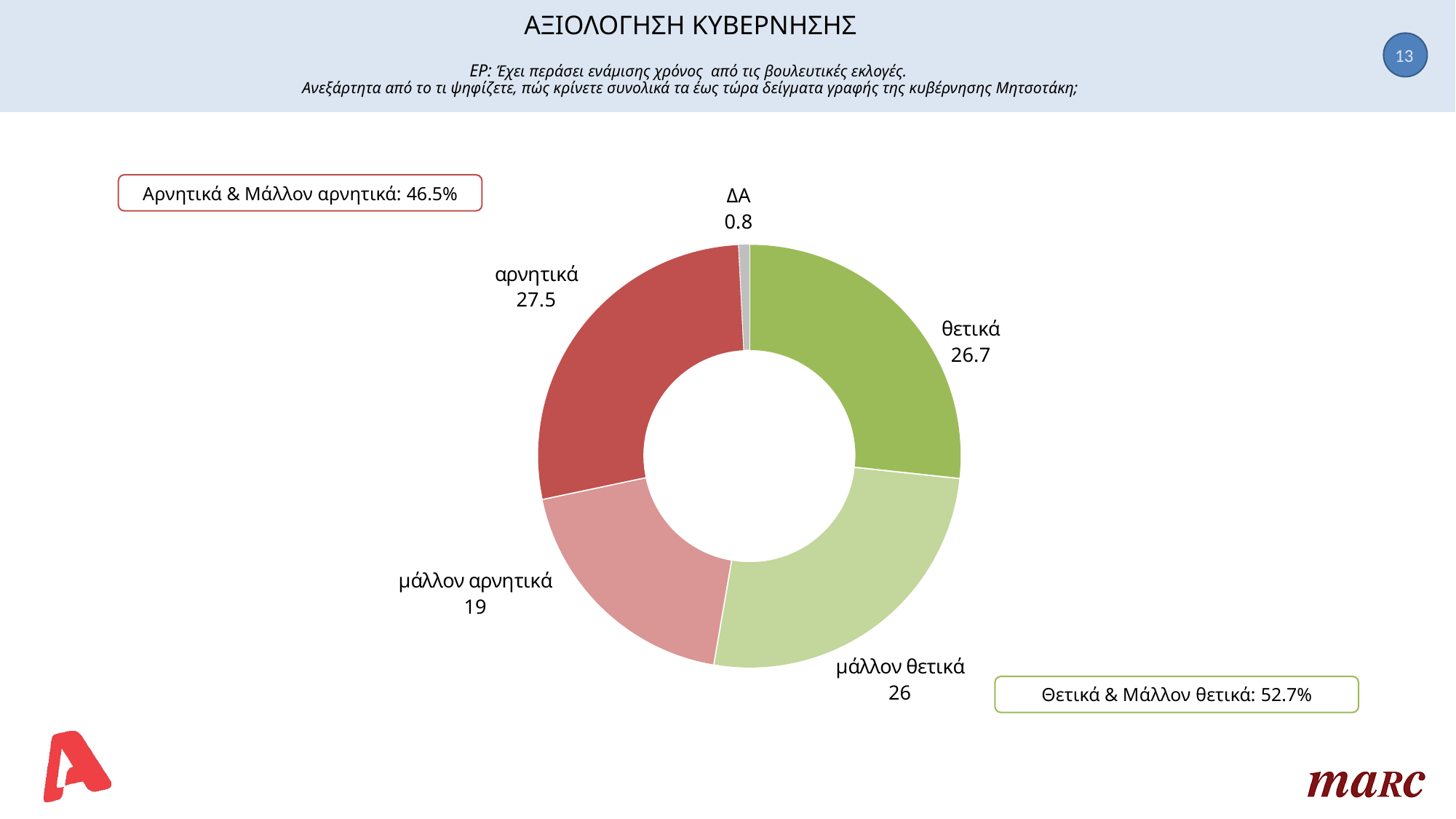
What is the difference between μάλλον θετικά and μάλλον αρνητικά? 7 Which category has the largest value? αρνητικά What is the difference between αρνητικά and θετικά? 0.8 What combined percentage does the slide give for Θετικά & Μάλλον θετικά? 52.7% What type of chart is shown on the slide? doughnut chart Which category has the smallest value? ΔΑ What is the value for μάλλον αρνητικά? 19 What is the value for θετικά? 26.7 What is the value for ΔΑ? 0.8 Which is larger, μάλλον θετικά or μάλλον αρνητικά? μάλλον θετικά What is the value for αρνητικά? 27.5 How many categories does the chart show? 5